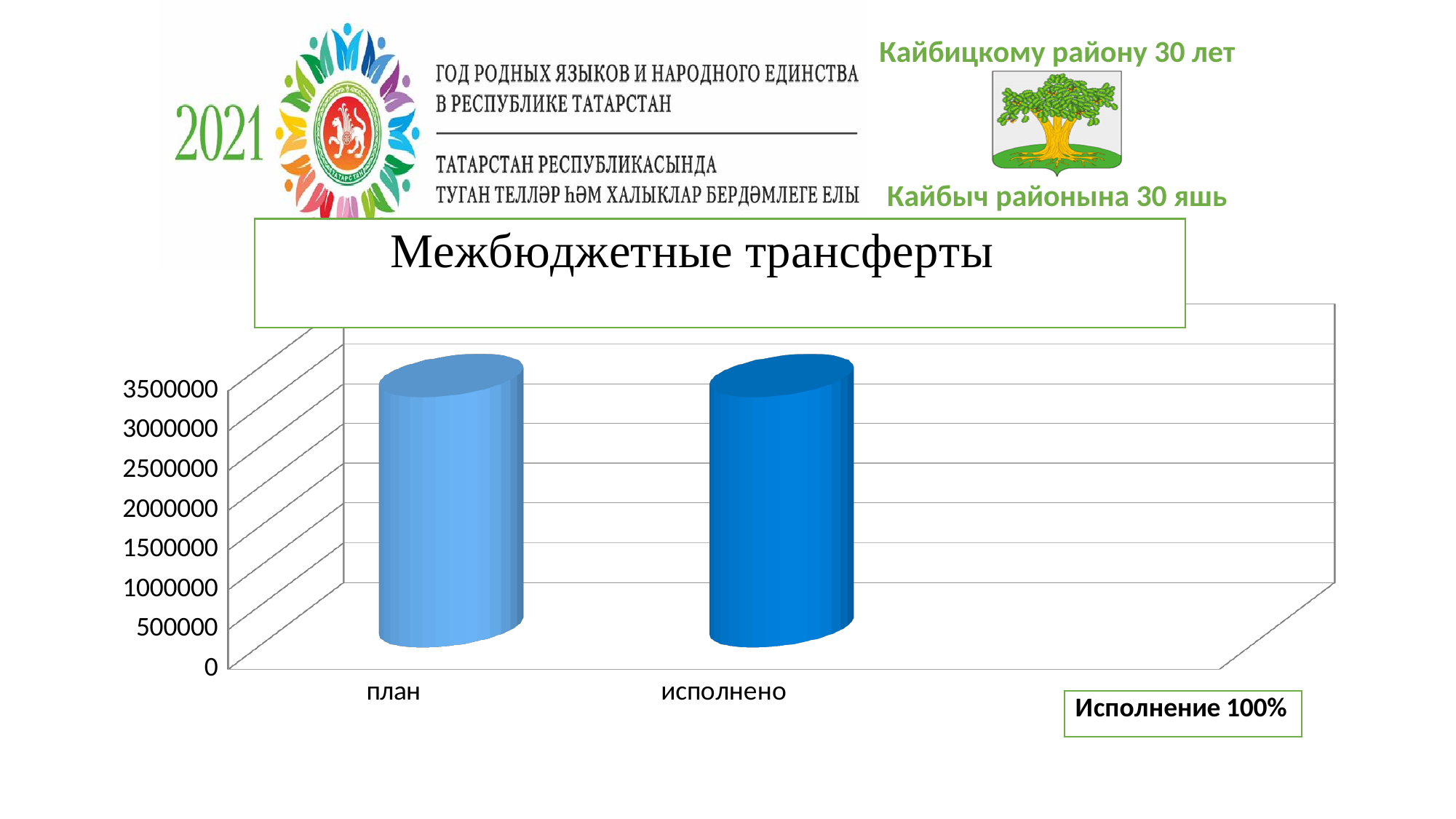
What is the highest tick value shown on the vertical axis? 3500000 What are the two category labels on the x axis? план, исполнено Is the value for план greater or less than 1000000? greater What kind of chart is shown on the slide? bar chart What execution percentage is stated in the box below the chart? Исполнение 100% What is the title of the chart? Межбюджетные трансферты Is the value for исполнено greater or less than 2500000? greater Is the value for план greater or less than 3000000? greater How many categories are plotted on the chart? 2